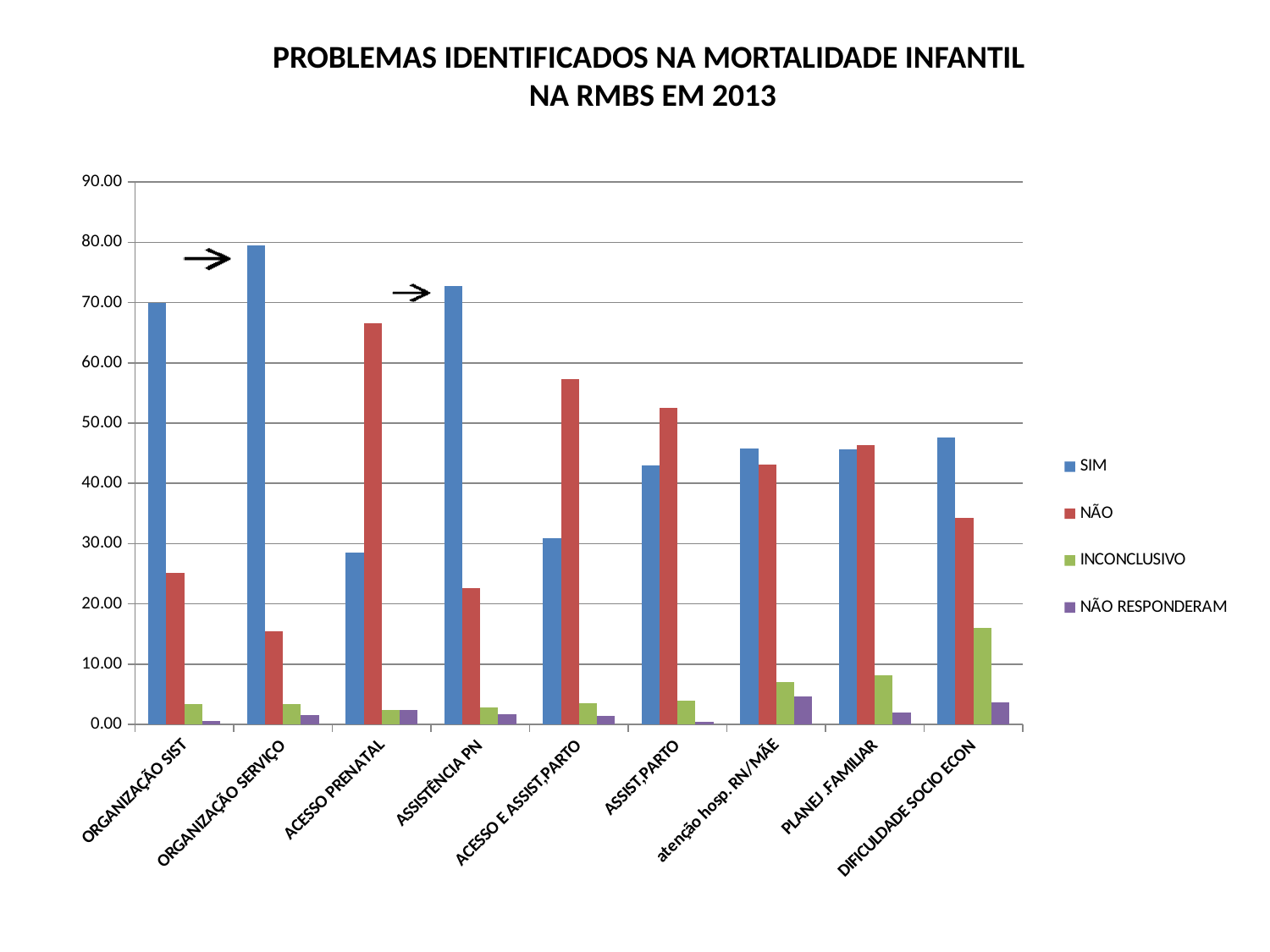
Is the SIM value for ACESSO PRENATAL greater or less than 40.00? less What kind of chart is shown on the slide? bar chart How many categories are shown along the x axis? 9 Is the SIM value for ORGANIZAÇÃO SIST greater or less than 60.00? greater For ASSIST.PARTO, which is larger, the SIM value or the NÃO value? NÃO Is the NÃO value for ACESSO PRENATAL greater or less than 60.00? greater Which category has the highest NÃO value? ACESSO PRENATAL What is the title of the chart? PROBLEMAS IDENTIFICADOS NA MORTALIDADE INFANTIL NA RMBS EM 2013 Which category has the highest SIM value? ORGANIZAÇÃO SERVIÇO How many series does the legend list? 4 Which category has the highest INCONCLUSIVO value? DIFICULDADE SOCIO ECON